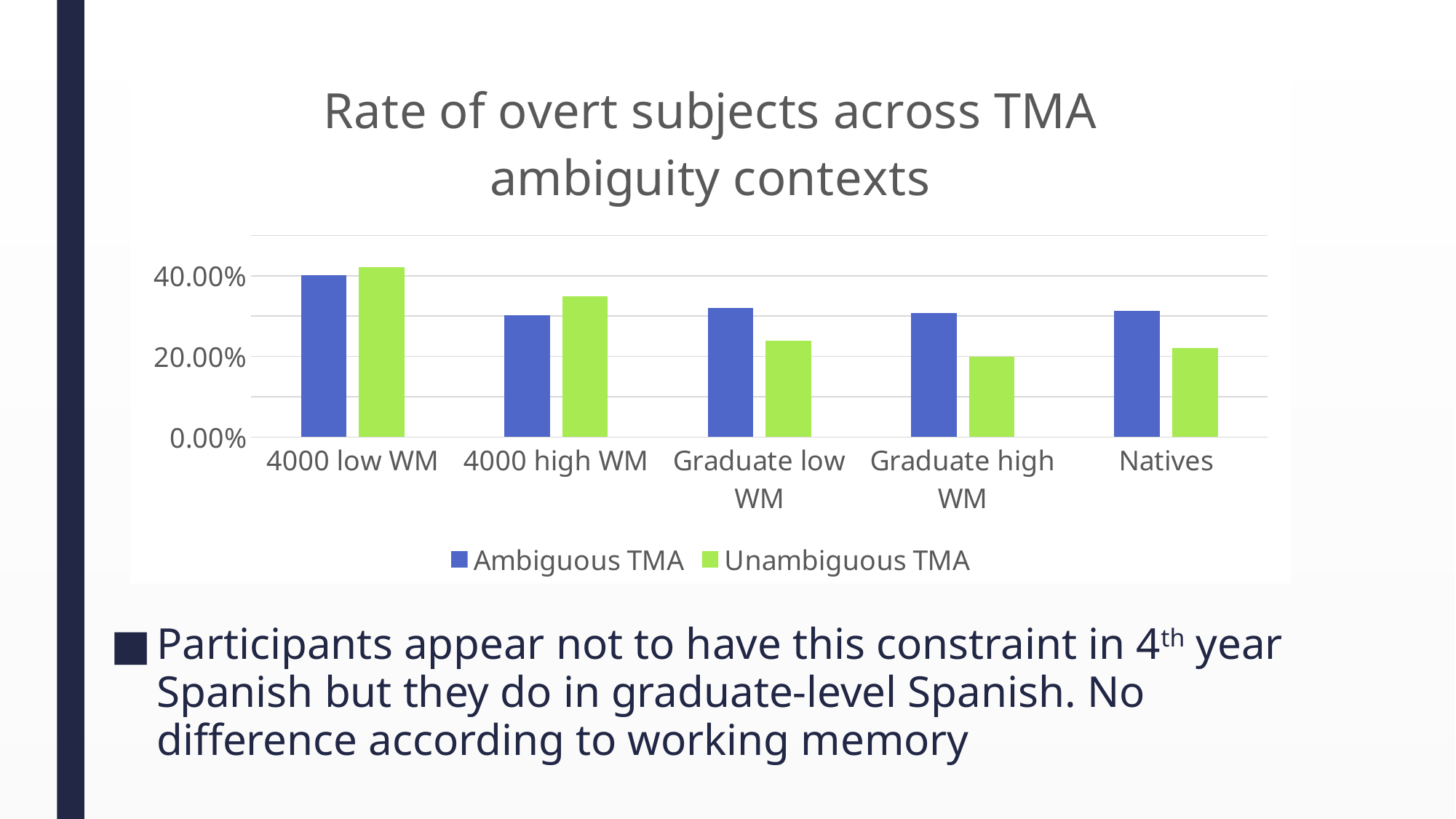
For Natives, which series has the larger value, Ambiguous TMA or Unambiguous TMA? Ambiguous TMA What kind of chart is shown on the slide? Bar chart Is the Unambiguous TMA value for 4000 high WM greater or less than 40.00%? less Which category has the highest Unambiguous TMA value? 4000 low WM Is the Unambiguous TMA value for Graduate low WM greater or less than 20.00%? greater Which category has the highest Ambiguous TMA value? 4000 low WM Is the Ambiguous TMA value for 4000 high WM greater or less than 20.00%? greater How many categories are shown on the x axis? 5 What is the title of the chart? Rate of overt subjects across TMA ambiguity contexts How many series does the legend list? 2 Which colour represents the Unambiguous TMA series? Green For Graduate low WM, which series has the larger value, Ambiguous TMA or Unambiguous TMA? Ambiguous TMA